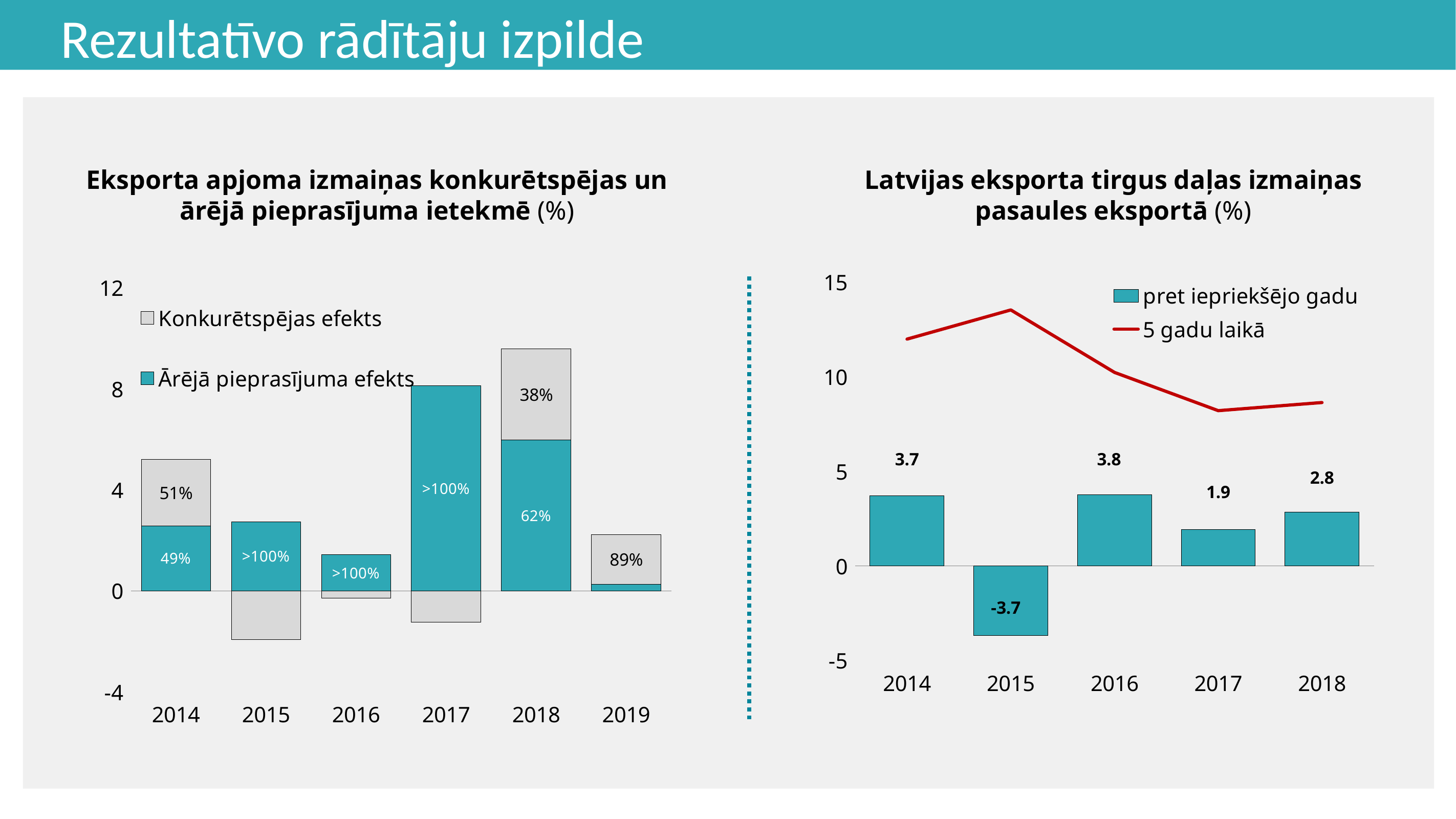
In the right chart (Latvijas eksporta tirgus daļas izmaiņas pasaules eksportā), how many years are shown on the x axis? 5 In the right chart (Latvijas eksporta tirgus daļas izmaiņas pasaules eksportā), is the '5 gadu laikā' value for 2015 greater or less than 10? greater In the right chart (Latvijas eksporta tirgus daļas izmaiņas pasaules eksportā), what is the difference between the 'pret iepriekšējo gadu' values for 2014 and 2015? 7.4 In the left chart (Eksporta apjoma izmaiņas konkurētspējas un ārējā pieprasījuma ietekmē), what label is shown on the 'Konkurētspējas efekts' segment for 2018? 38% What kind of chart is the left chart (Eksporta apjoma izmaiņas konkurētspējas un ārējā pieprasījuma ietekmē)? stacked bar chart In the right chart (Latvijas eksporta tirgus daļas izmaiņas pasaules eksportā), how many series does the legend list? 2 In the right chart (Latvijas eksporta tirgus daļas izmaiņas pasaules eksportā), what is the value of the 'pret iepriekšējo gadu' bar for 2017? 1.9 In the left chart (Eksporta apjoma izmaiņas konkurētspējas un ārējā pieprasījuma ietekmē), what label is shown on the 'Ārējā pieprasījuma efekts' segment for 2014? 49% In the left chart (Eksporta apjoma izmaiņas konkurētspējas un ārējā pieprasījuma ietekmē), how many years are shown on the x axis? 6 In the right chart (Latvijas eksporta tirgus daļas izmaiņas pasaules eksportā), what is the value of the 'pret iepriekšējo gadu' bar for 2015? -3.7 In the right chart (Latvijas eksporta tirgus daļas izmaiņas pasaules eksportā), which year has the lowest 'pret iepriekšējo gadu' value? 2015 In the right chart (Latvijas eksporta tirgus daļas izmaiņas pasaules eksportā), is the 'pret iepriekšējo gadu' value for 2018 larger or smaller than the value for 2017? larger